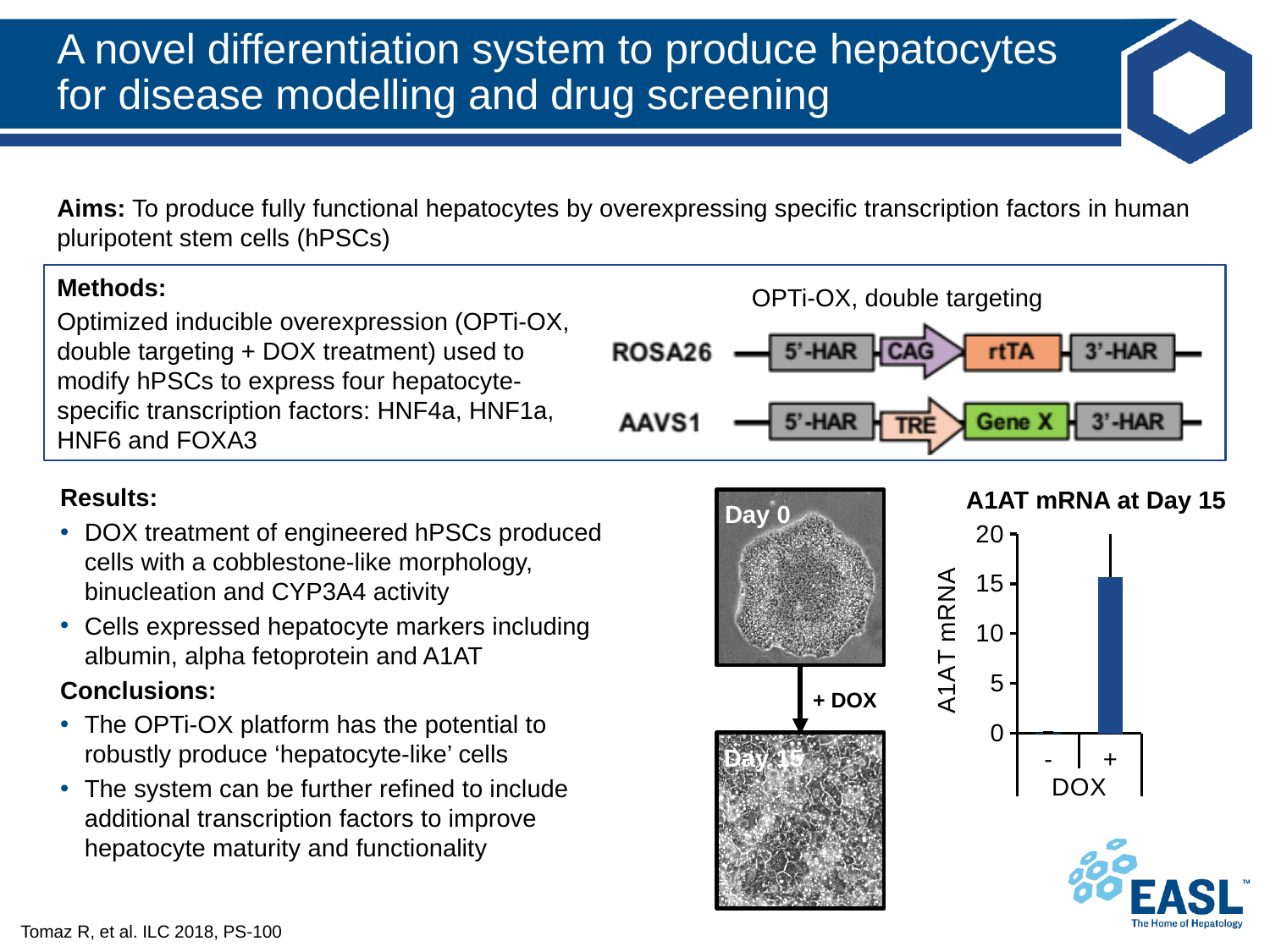
What kind of chart is the A1AT mRNA at Day 15 chart? bar chart In the A1AT mRNA at Day 15 chart, is the value for + DOX greater or less than 20? less In the A1AT mRNA at Day 15 chart, is the value for + DOX greater or less than 10? greater What is the title of the chart on the slide? A1AT mRNA at Day 15 In the A1AT mRNA at Day 15 chart, which DOX condition has the highest A1AT mRNA value? + In the A1AT mRNA at Day 15 chart, is the A1AT mRNA value larger for + DOX or - DOX? + DOX What is the label of the y axis in the A1AT mRNA at Day 15 chart? A1AT mRNA In the A1AT mRNA at Day 15 chart, is the value for - DOX greater or less than 5? less How many categories are shown on the x axis of the A1AT mRNA at Day 15 chart? 2 In the A1AT mRNA at Day 15 chart, which DOX condition has the lowest A1AT mRNA value? - What is the maximum value shown on the y axis of the A1AT mRNA at Day 15 chart? 20